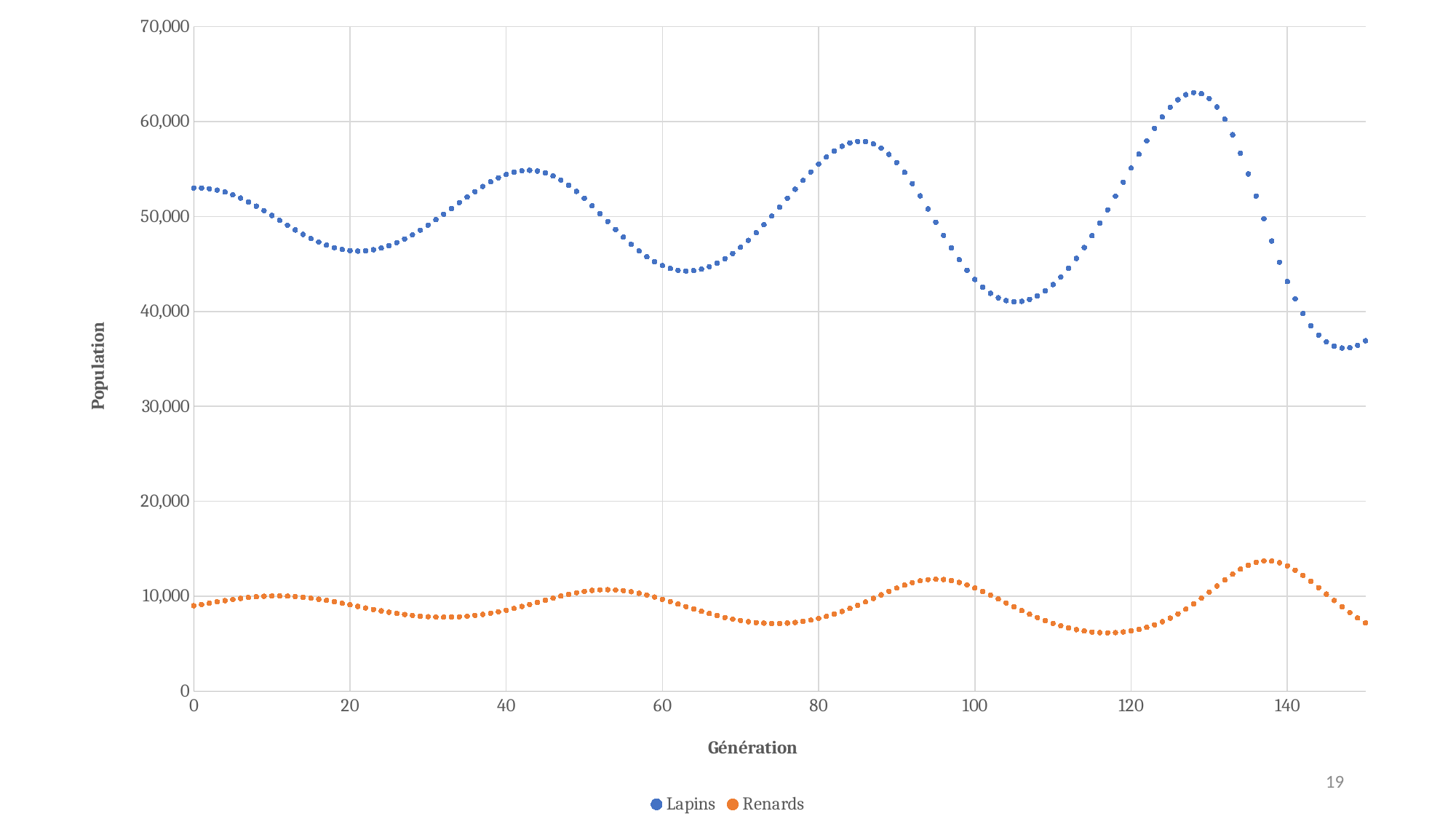
Is the value for Lapins at generation 0 greater or less than 50,000? greater What kind of chart is shown on the slide? scatter chart Is the value for Lapins at generation 20 greater or less than 50,000? less Does the Lapins series rise or fall between generation 105 and generation 130? rise Is the value for Renards at generation 140 greater or less than 10,000? greater What is the title of the x axis? Génération How many series does the legend list? 2 Does the Lapins series rise or fall between generation 0 and generation 20? fall Which series has the higher population values throughout the chart, Lapins or Renards? Lapins